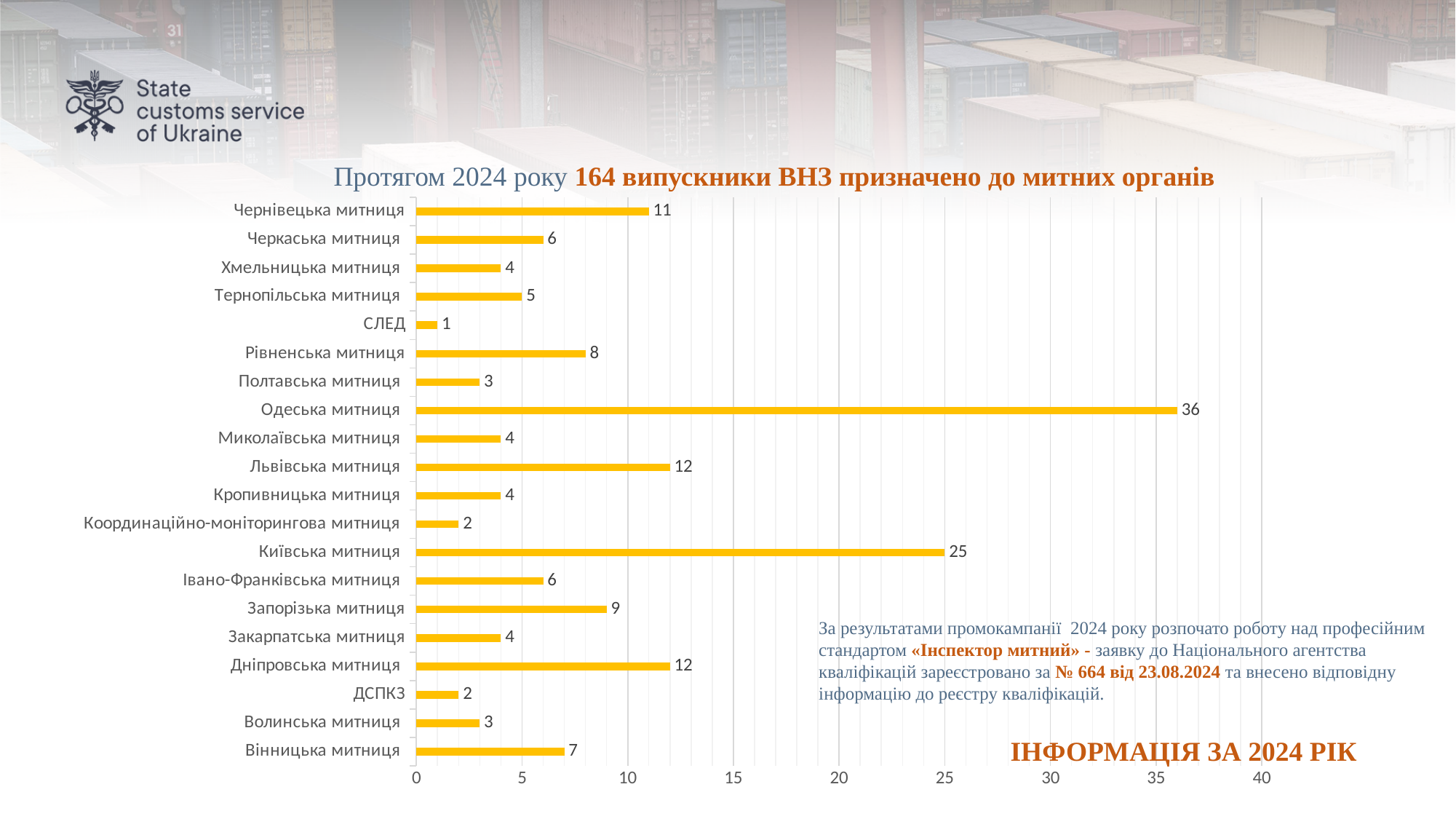
What value is shown for Чернівецька митниця? 11 What value is shown for Одеська митниця? 36 What is the difference between the values for Дніпровська митниця and Волинська митниця? 9 Which is larger, the value for Запорізька митниця or the value for Рівненська митниця? Запорізька митниця What value is shown for Київська митниця? 25 What value is shown for Вінницька митниця? 7 How many categories are shown in the chart? 20 What is the difference between the values for Одеська митниця and Київська митниця? 11 Which category has the highest value? Одеська митниця Is the value for Львівська митниця greater or less than 10? greater Which category has the lowest value? СЛЕД What kind of chart is shown on the slide? bar chart